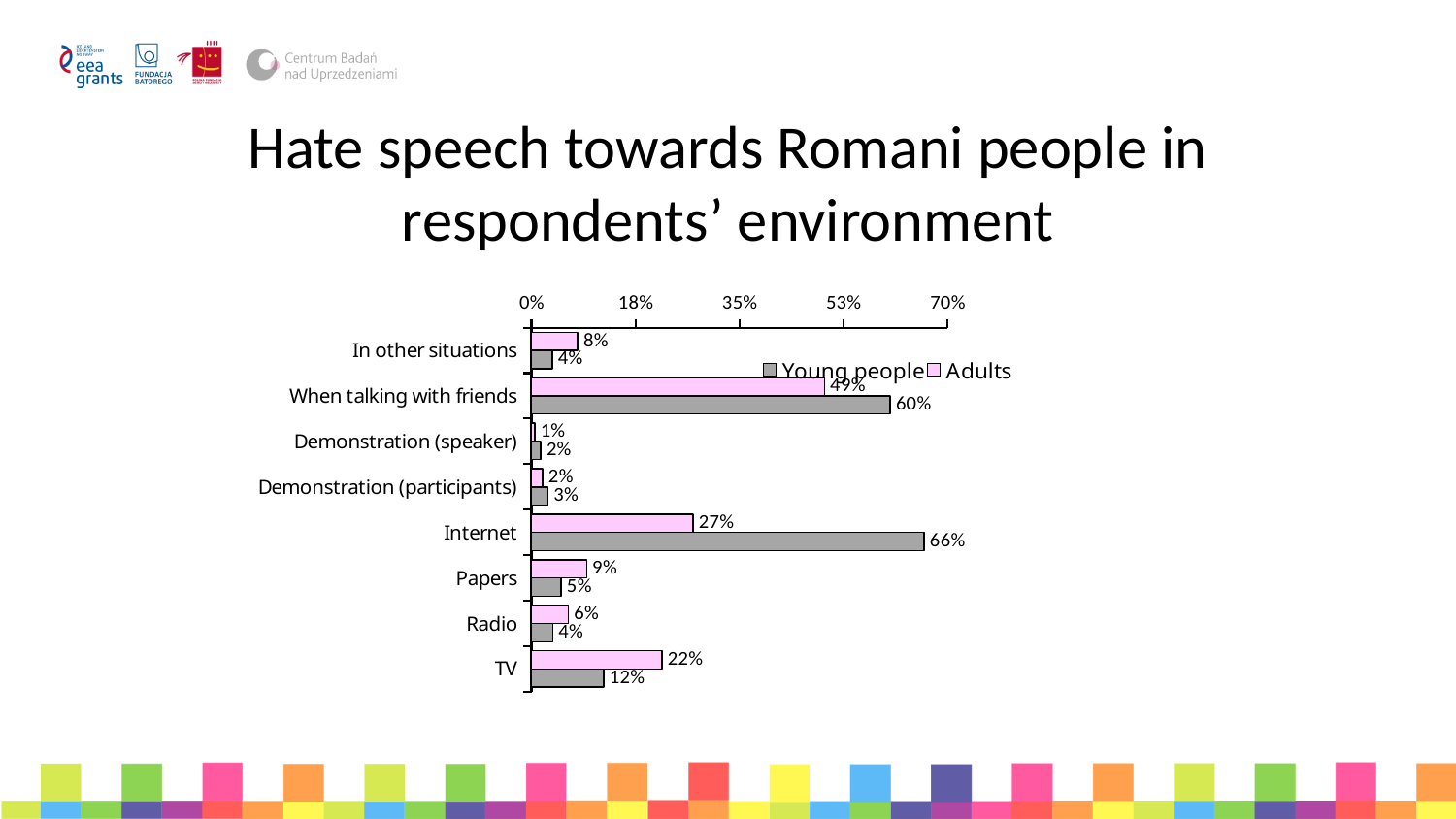
What is the value for Adults for When talking with friends? 49% What is the value for Adults for TV? 22% How many categories are shown on the chart? 8 Is the value for Young people for When talking with friends greater or less than 53%? greater Which category has the highest value for Young people? Internet How many series does the legend list? 2 Which series is shown in pink in the legend? Adults What kind of chart is shown on the slide? bar chart Which category has the lowest value for Adults? Demonstration (speaker) What is the difference between the Young people and Adults values for Internet? 39% What is the value for Young people for Internet? 66% For Papers, which series has the larger value, Young people or Adults? Adults